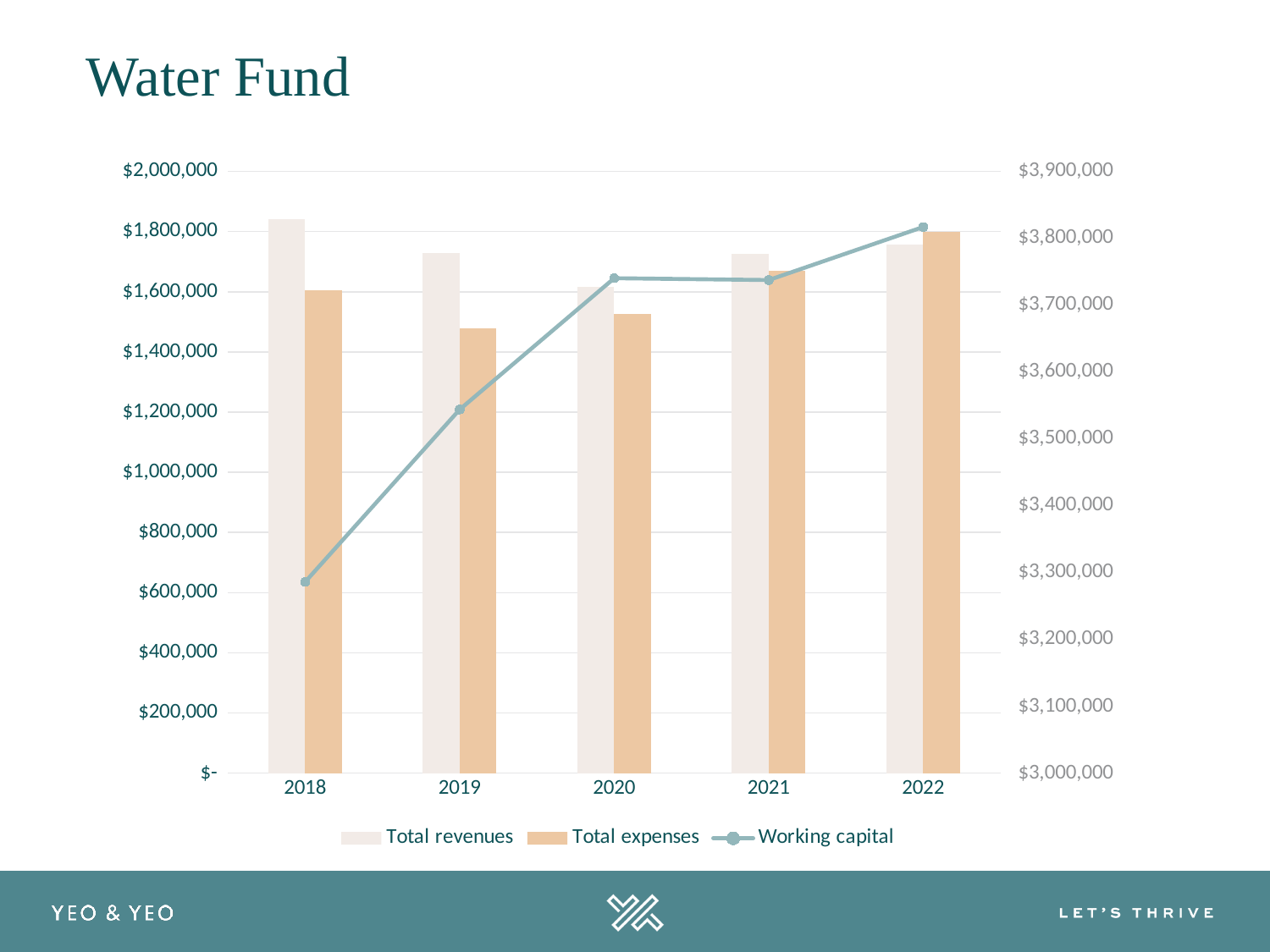
In which year are Total expenses highest? 2022 In which year are Total revenues lowest? 2020 In 2022, which is larger: Total revenues or Total expenses? Total expenses Is the value for Working capital in 2018 greater or less than $3,400,000? less Is the value for Total revenues in 2018 greater or less than $1,800,000? greater In which year is Working capital lowest? 2018 What is the title of the chart? Water Fund How many series does the legend list? 3 In which year are Total revenues highest? 2018 How many years are shown on the x axis? 5 In which year are Total expenses lowest? 2019 What kind of chart is shown on the slide? Bar chart combined with a line